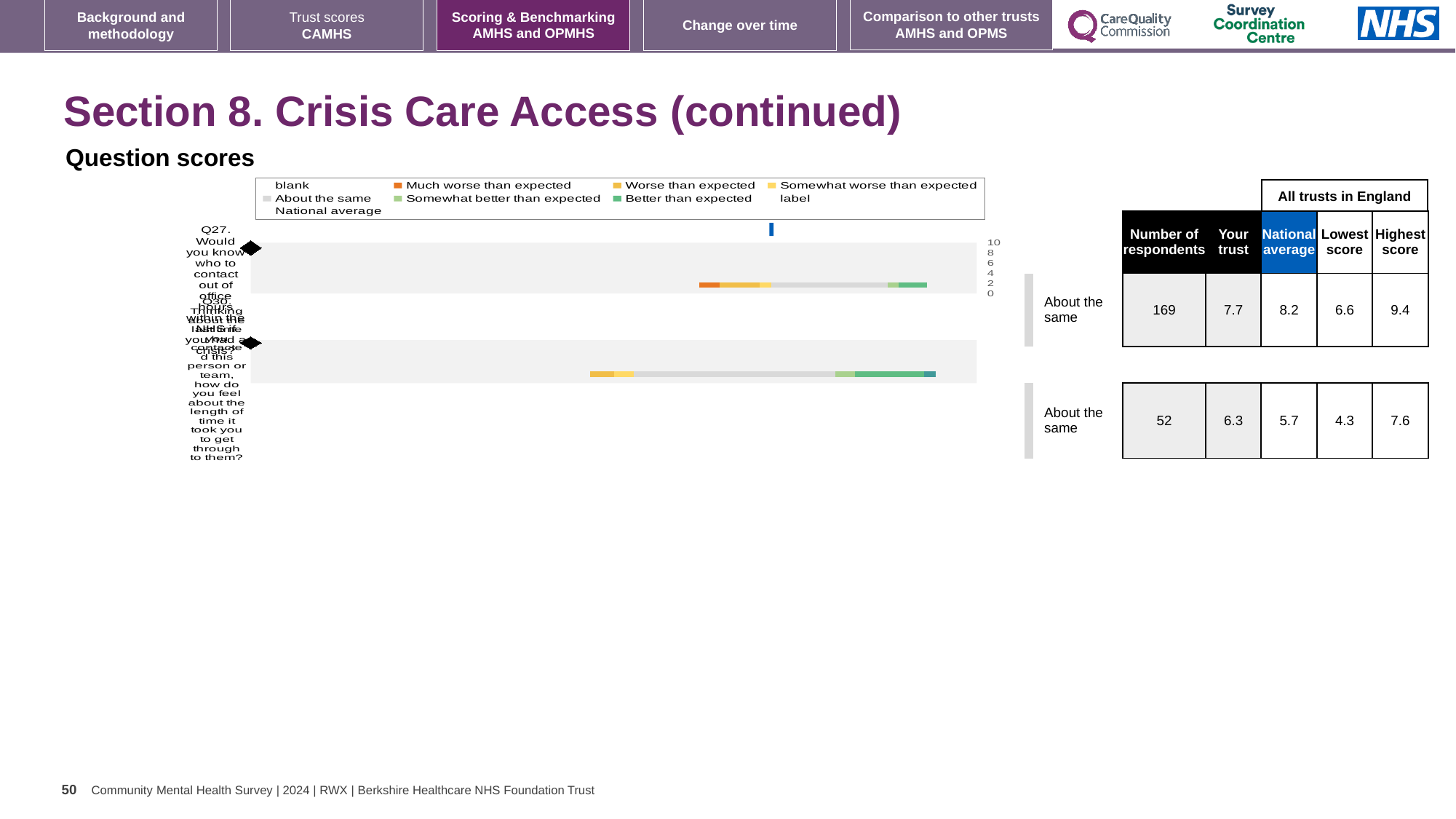
In the table beside the chart, what is the difference between the Highest score and Lowest score for Q27? 2.8 In the table beside the chart, what is the number of respondents for Q30? 52 In the table beside the chart, what is the 'Your trust' score for Q27 (knowing who to contact out of office hours)? 7.7 In the table beside the chart, what is the National average for Q27? 8.2 How many entries does the legend of the Question scores chart list? 9 How many questions (bars) are plotted in the Question scores chart? 2 Which legend entry in the Question scores chart is shown in orange? Much worse than expected In the table beside the chart, which is larger for Q30: Your trust score or the National average? Your trust In the table beside the chart, what is the 'Your trust' score for Q30 (length of time to get through)? 6.3 What is the highest tick value shown on the axis of the Question scores chart? 10 What kind of chart is shown under 'Question scores'? bar chart What benchmark category label is shown next to both Q27 and Q30 in the chart? About the same